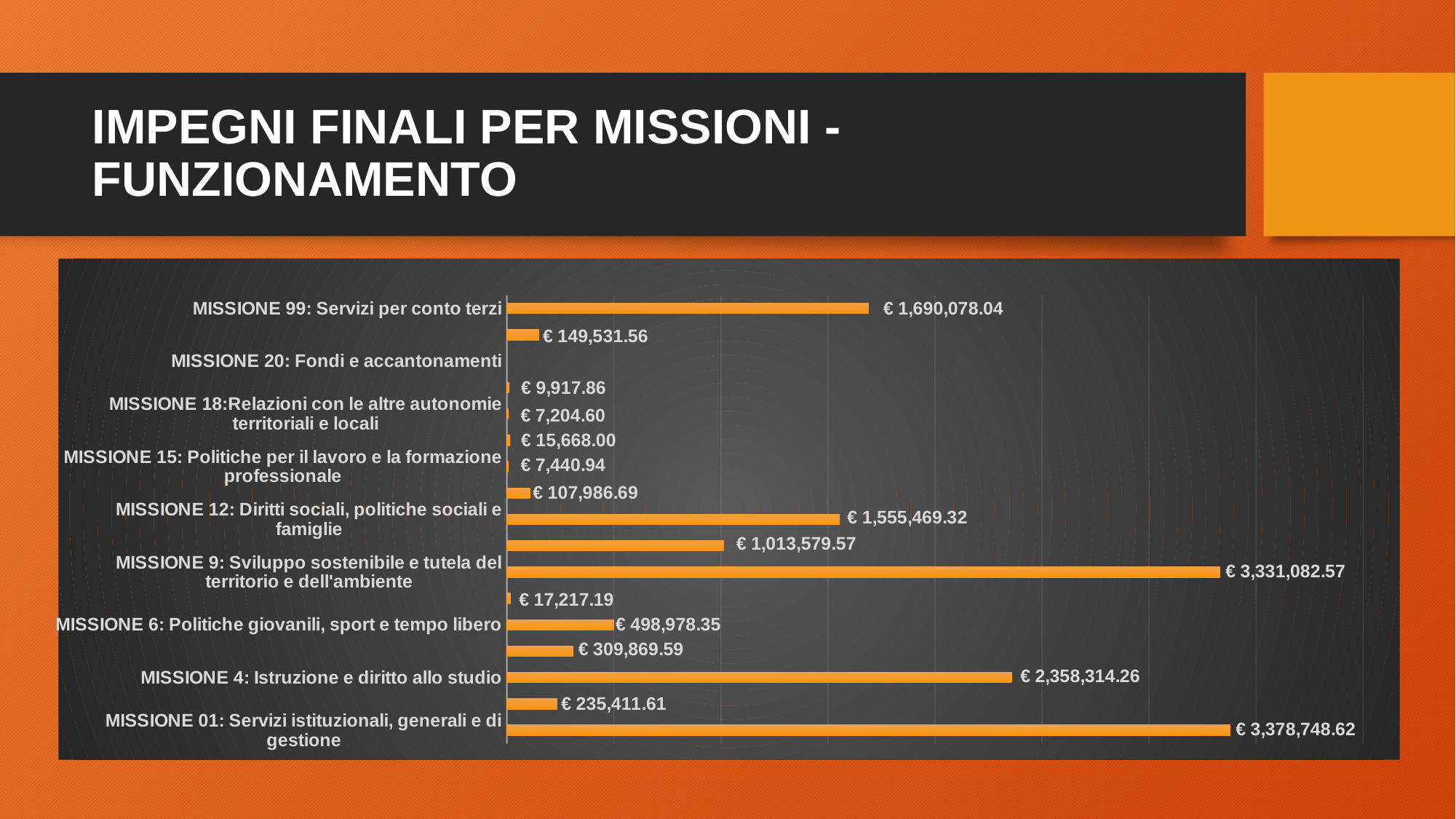
Which labelled mission has the highest value in the chart? MISSIONE 01: Servizi istituzionali, generali e di gestione What is the value shown for MISSIONE 99: Servizi per conto terzi? € 1,690,078.04 What is the value shown for MISSIONE 6: Politiche giovanili, sport e tempo libero? € 498,978.35 What is the difference between the values for MISSIONE 4 and MISSIONE 99? € 668,236.22 What is the value shown for MISSIONE 4: Istruzione e diritto allo studio? € 2,358,314.26 What is the difference between the values for MISSIONE 01 and MISSIONE 9? € 47,666.05 What is the title of the slide containing the chart? IMPEGNI FINALI PER MISSIONI - FUNZIONAMENTO What kind of chart is shown on the slide? Bar chart Which has the larger value, MISSIONE 4: Istruzione e diritto allo studio or MISSIONE 99: Servizi per conto terzi? MISSIONE 4: Istruzione e diritto allo studio What is the value shown for MISSIONE 01: Servizi istituzionali, generali e di gestione? € 3,378,748.62 Which has the larger value, MISSIONE 12: Diritti sociali, politiche sociali e famiglie or MISSIONE 6: Politiche giovanili, sport e tempo libero? MISSIONE 12: Diritti sociali, politiche sociali e famiglie What is the value shown for MISSIONE 9: Sviluppo sostenibile e tutela del territorio e dell'ambiente? € 3,331,082.57